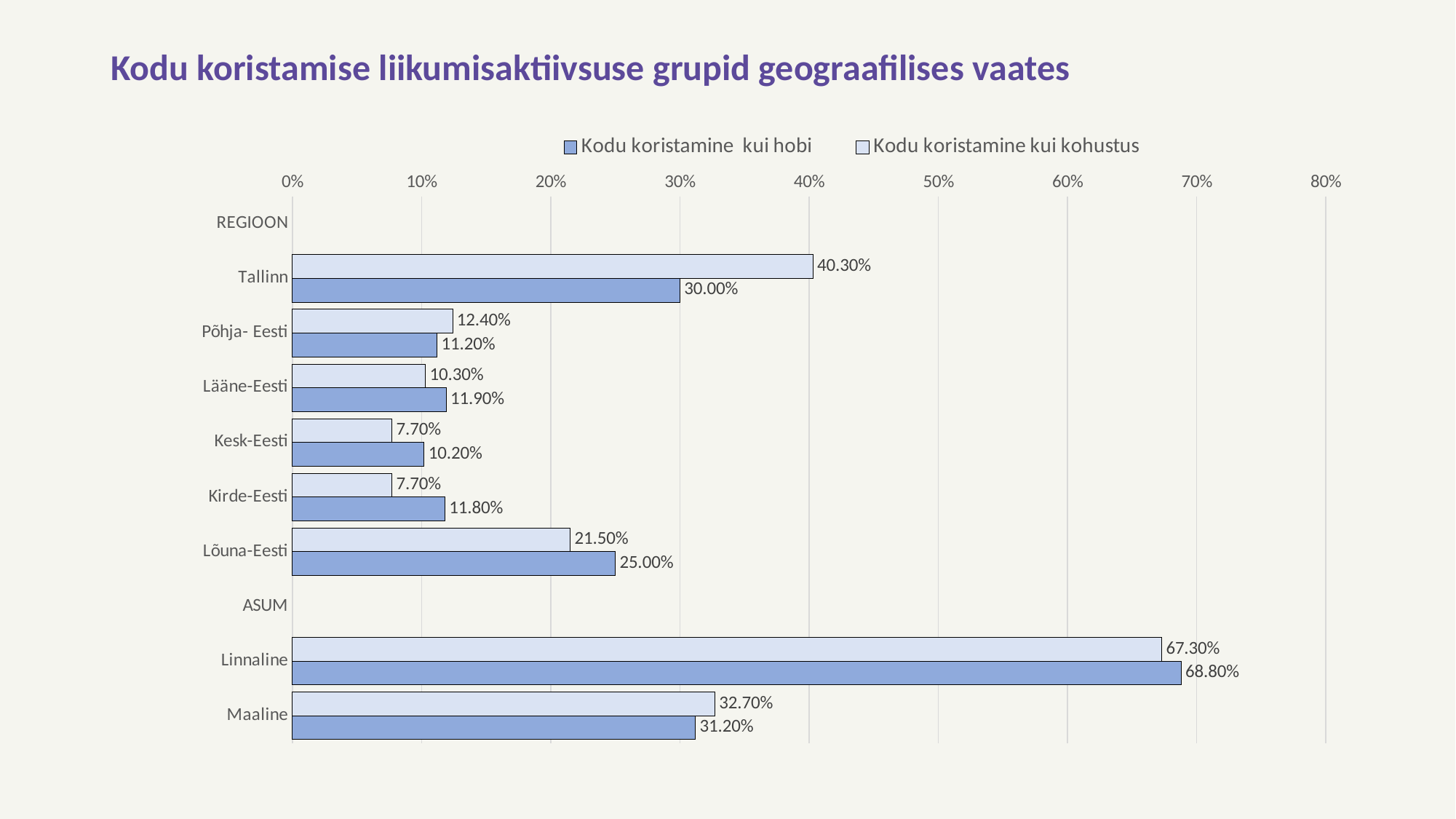
How many categories have bars plotted in the chart? 8 For Kirde-Eesti, which series has the larger value: 'Kodu koristamine kui hobi' or 'Kodu koristamine kui kohustus'? Kodu koristamine kui hobi Which category has the lowest value in the 'Kodu koristamine kui hobi' series? Kesk-Eesti What is the difference between the 'Kodu koristamine kui kohustus' and 'Kodu koristamine kui hobi' values for Tallinn? 10.30% Which category has the highest value in the 'Kodu koristamine kui hobi' series? Linnaline What is the title of the chart? Kodu koristamise liikumisaktiivsuse grupid geograafilises vaates Is the 'Kodu koristamine kui hobi' value for Linnaline greater or less than 60%? greater What is the value for Lõuna-Eesti in the 'Kodu koristamine kui hobi' series? 25.00% How many series does the legend list? 2 What is the value for Tallinn in the 'Kodu koristamine kui kohustus' series? 40.30% What type of chart is shown on the slide? bar chart What is the value for Maaline in the 'Kodu koristamine kui kohustus' series? 32.70%